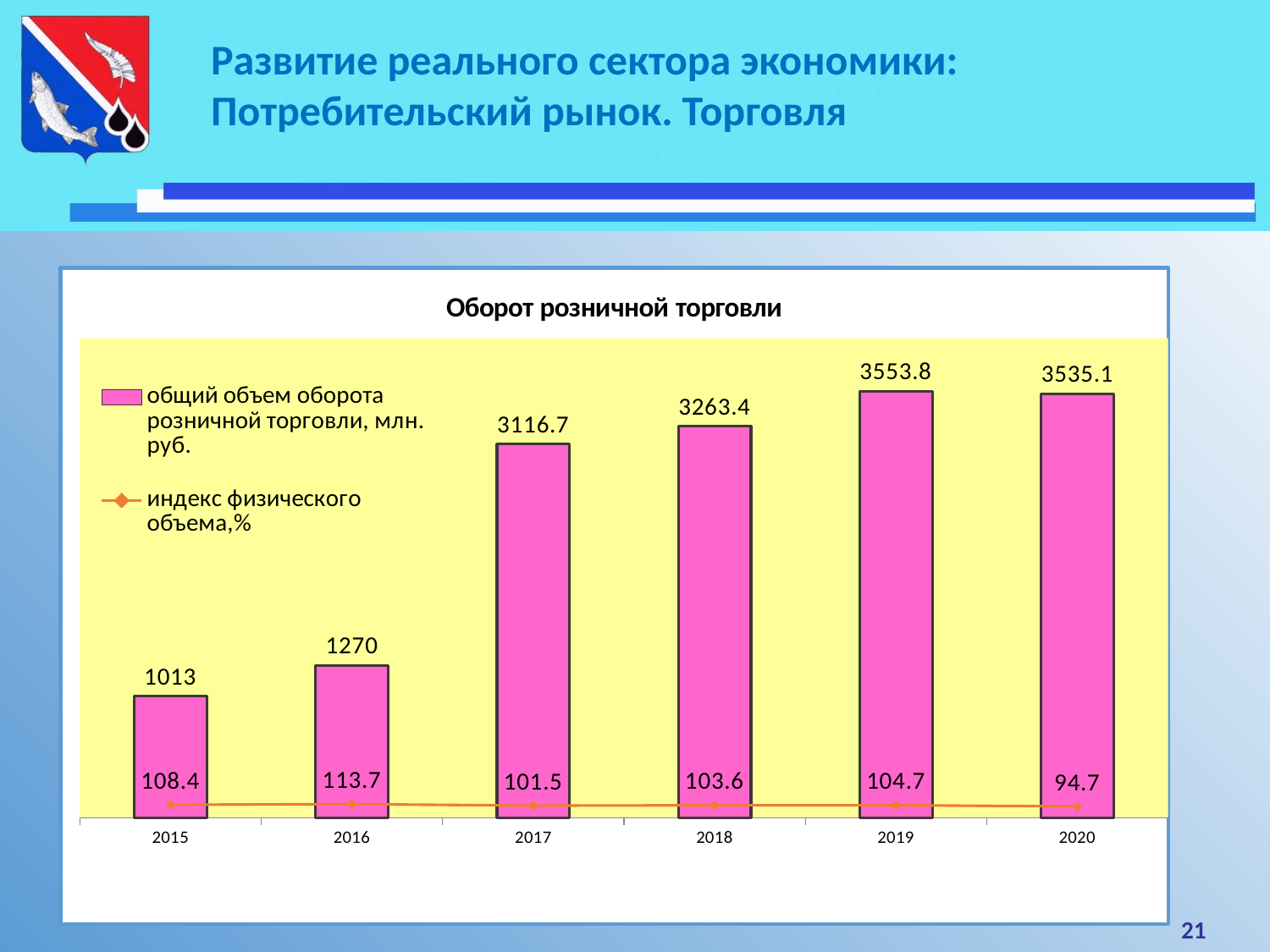
What is the difference in total retail trade turnover between 2019 and 2020? 18.7 Which is larger: the retail trade turnover in 2017 or in 2018? 2018 Which year has the highest total retail trade turnover? 2019 How many years are shown on the x axis? 6 Does the total retail trade turnover rise or fall from 2015 to 2019? rise What is the title of the chart? Оборот розничной торговли How many series does the legend list? 2 Which year has the lowest total retail trade turnover? 2015 What kind of chart is used for the total retail trade turnover series? bar chart What is the physical volume index (индекс физического объема, %) for 2016? 113.7 What is the total retail trade turnover (общий объем оборота розничной торговли, млн. руб.) for 2018? 3263.4 Which year has the lowest physical volume index? 2020